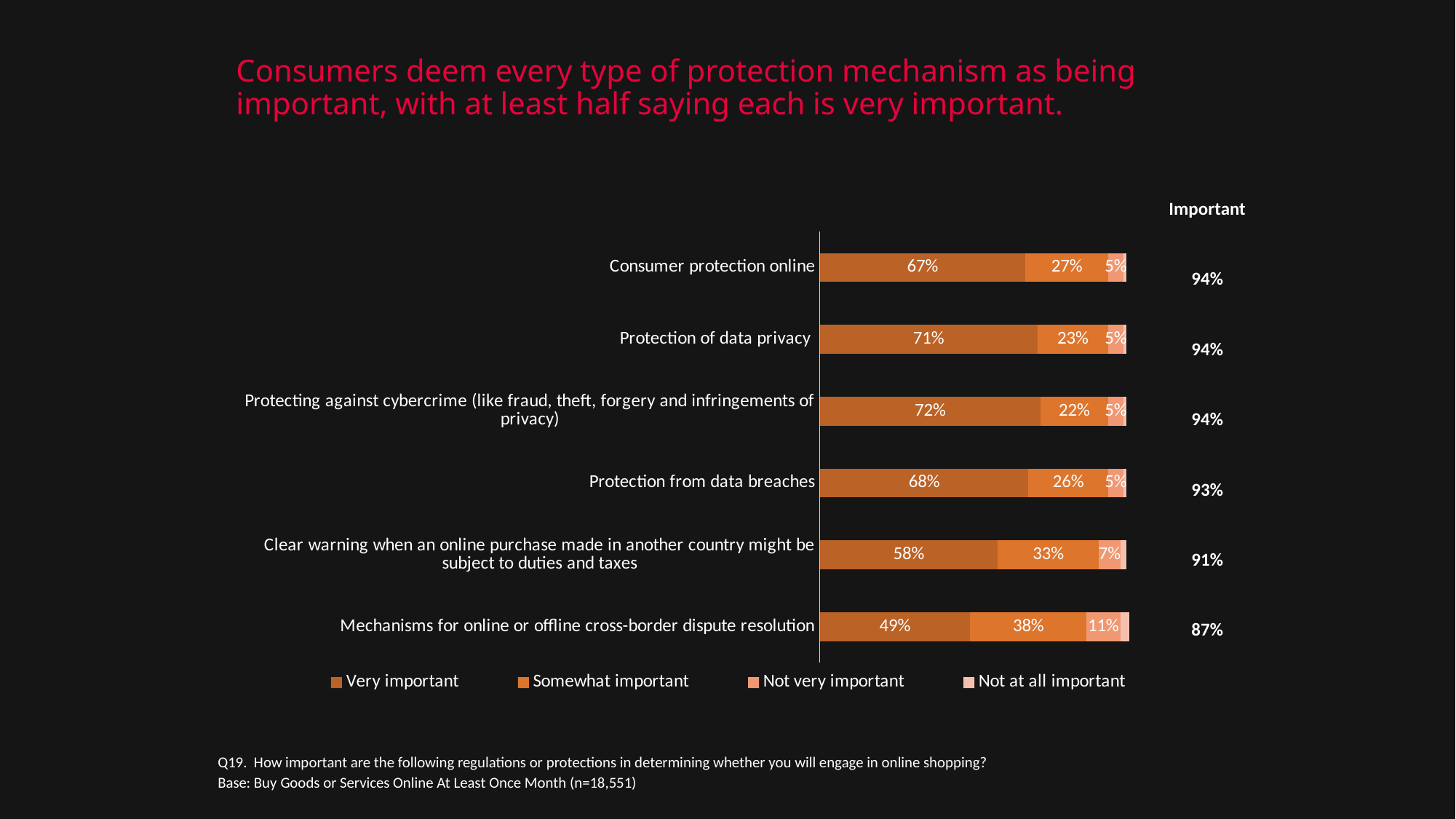
How many categories are shown in the chart? 6 What percentage of consumers rate Consumer protection online as Very important? 67% What is the Not very important value for Clear warning when an online purchase made in another country might be subject to duties and taxes? 7% Which has a larger Somewhat important percentage: Protection from data breaches or Protection of data privacy? Protection from data breaches What is the difference between the Very important percentages for Protection of data privacy and Consumer protection online? 4% Which category has the lowest Very important percentage? Mechanisms for online or offline cross-border dispute resolution What is the Somewhat important value for Mechanisms for online or offline cross-border dispute resolution? 38% What is the combined Important percentage shown for Protection from data breaches? 93% How many series does the legend list? 4 Which category has the highest Very important percentage? Protecting against cybercrime (like fraud, theft, forgery and infringements of privacy) What is the combined Important percentage for Mechanisms for online or offline cross-border dispute resolution? 87% What kind of chart is shown on the slide? Stacked bar chart